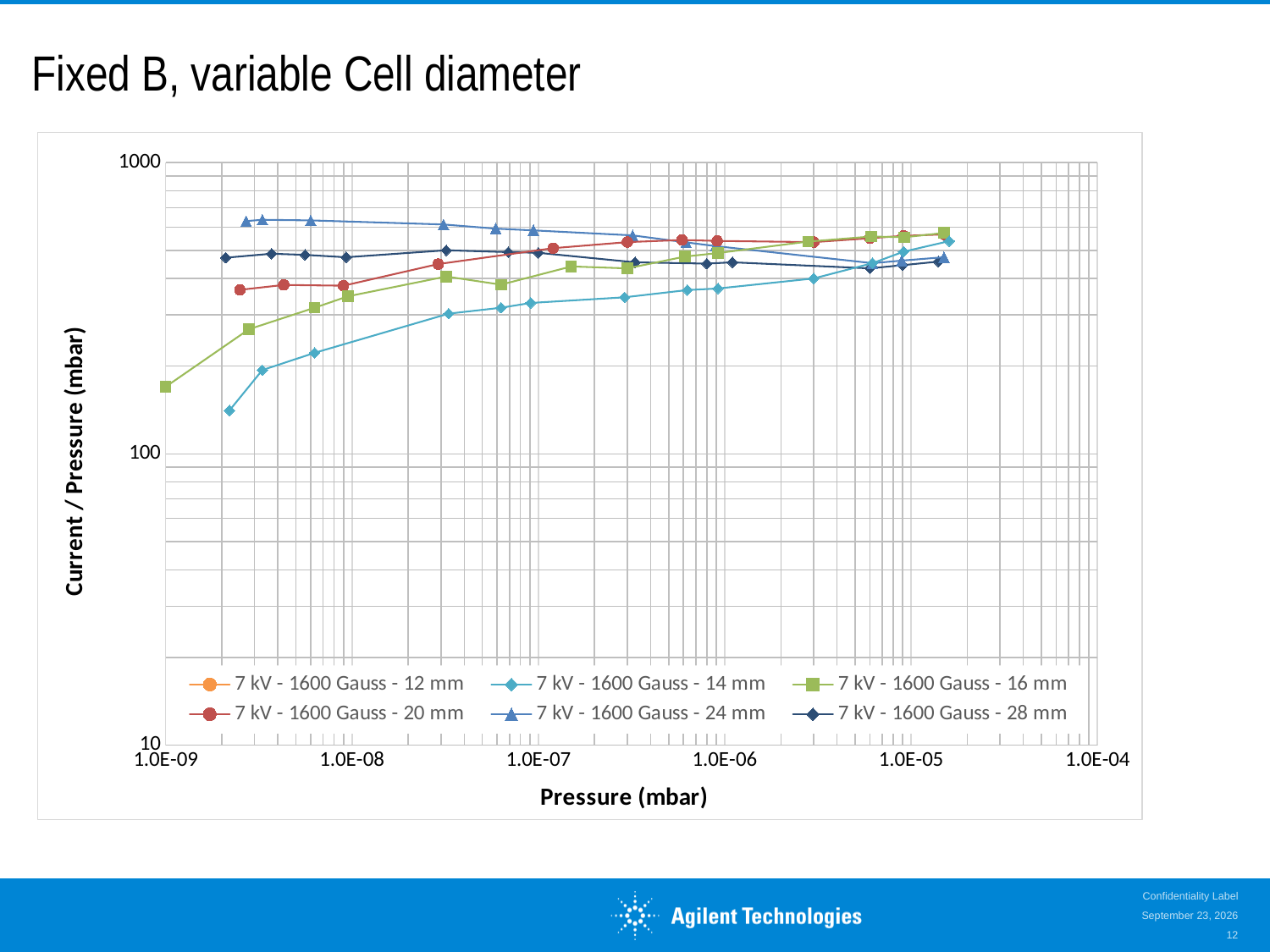
Near a pressure of 1.0E-08 mbar, which series has the highest Current / Pressure value? 7 kV - 1600 Gauss - 24 mm What is the title of the slide containing the chart? Fixed B, variable Cell diameter What is the label of the x axis? Pressure (mbar) Is the value of the 7 kV - 1600 Gauss - 14 mm series at its lowest pressure point greater or less than 100? greater Does the 7 kV - 1600 Gauss - 14 mm series rise or fall as pressure increases along the x axis? rise Is the value of the 7 kV - 1600 Gauss - 24 mm series at its lowest pressure point greater or less than 1000? less Near a pressure of 1.0E-08 mbar, which series has the lowest Current / Pressure value? 7 kV - 1600 Gauss - 14 mm What kind of chart is shown on the slide? line chart Does the 7 kV - 1600 Gauss - 24 mm series rise or fall as pressure increases along the x axis? fall Near a pressure of 1.0E-07 mbar, which is larger: the 7 kV - 1600 Gauss - 28 mm series or the 7 kV - 1600 Gauss - 14 mm series? 7 kV - 1600 Gauss - 28 mm At the lowest pressures plotted, which is larger: the 7 kV - 1600 Gauss - 24 mm series or the 7 kV - 1600 Gauss - 14 mm series? 7 kV - 1600 Gauss - 24 mm How many series does the legend list? 6